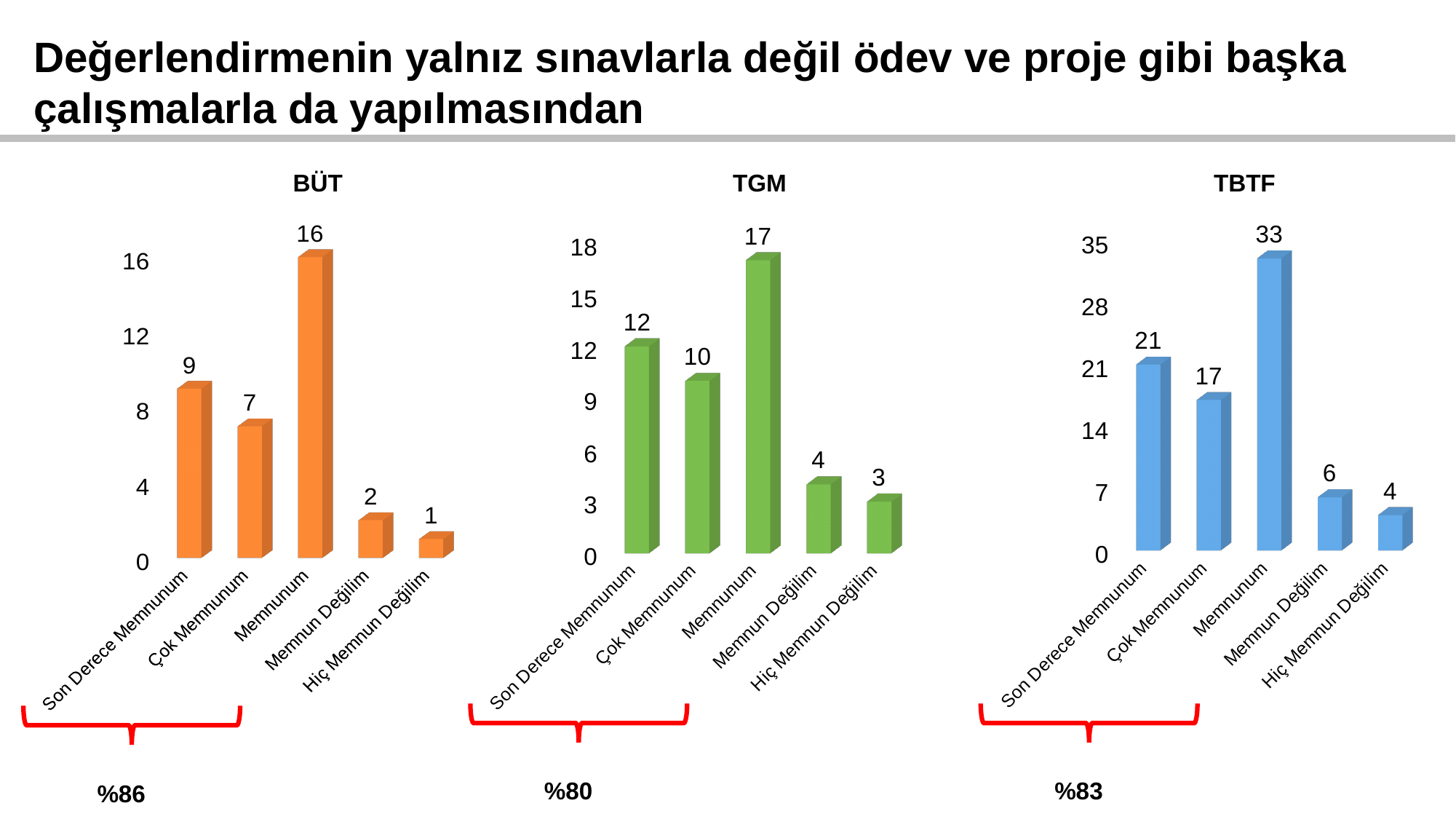
In the BÜT chart, what is the value for Memnunum? 16 In the TGM chart, what is the value for Son Derece Memnunum? 12 In the TBTF chart, which category has the highest value? Memnunum In the TGM chart, what is the difference between Memnunum and Çok Memnunum? 7 How many categories does the TGM chart show? 5 In the TBTF chart, what is the difference between Memnunum and Son Derece Memnunum? 12 In the BÜT chart, which category has the lowest value? Hiç Memnun Değilim In the TBTF chart, what is the value for Çok Memnunum? 17 In the BÜT chart, which is larger: Son Derece Memnunum or Çok Memnunum? Son Derece Memnunum In the TGM chart, is the value for Memnunum greater or less than 15? greater What kind of chart is the TBTF chart? bar chart What percentage is shown below the BÜT chart? %86